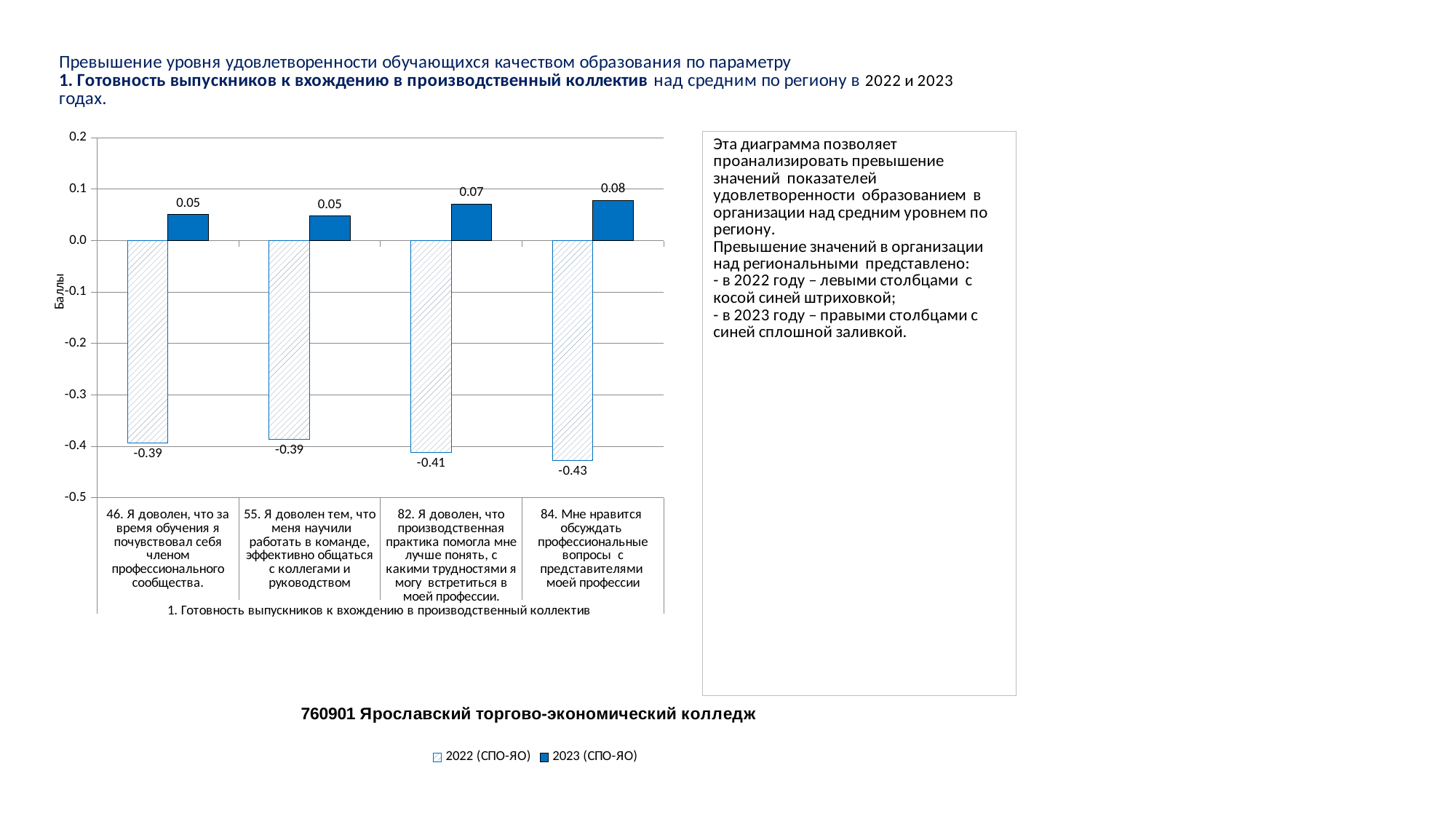
Какое значение для 2022 (СПО-ЯО) по категории «82. Я доволен, что производственная практика помогла мне лучше понять, с какими трудностями я могу встретиться в моей профессии.»? -0.41 Сколько рядов данных перечислено в легенде диаграммы? 2 Какое значение больше: 2023 (СПО-ЯО) по категории 82 или 2023 (СПО-ЯО) по категории 46? 2023 (СПО-ЯО) по категории 82 Какова разница между значениями 2023 (СПО-ЯО) и 2022 (СПО-ЯО) по категории «84. Мне нравится обсуждать профессиональные вопросы с представителями моей профессии»? 0.51 Как называется ось Y на диаграмме? Баллы Сколько категорий показано на диаграмме? 4 В какой категории значение для 2023 (СПО-ЯО) самое высокое? 84. Мне нравится обсуждать профессиональные вопросы с представителями моей профессии Какого типа эта диаграмма? Столбчатая (bar chart) Какое значение для 2023 (СПО-ЯО) по категории «55. Я доволен тем, что меня научили работать в команде, эффективно общаться с коллегами и руководством»? 0.05 Какое значение для 2022 (СПО-ЯО) по категории «46. Я доволен, что за время обучения я почувствовал себя членом профессионального сообщества.»? -0.39 Какое значение для 2023 (СПО-ЯО) по категории «84. Мне нравится обсуждать профессиональные вопросы с представителями моей профессии»? 0.08 В какой категории значение для 2022 (СПО-ЯО) самое низкое? 84. Мне нравится обсуждать профессиональные вопросы с представителями моей профессии